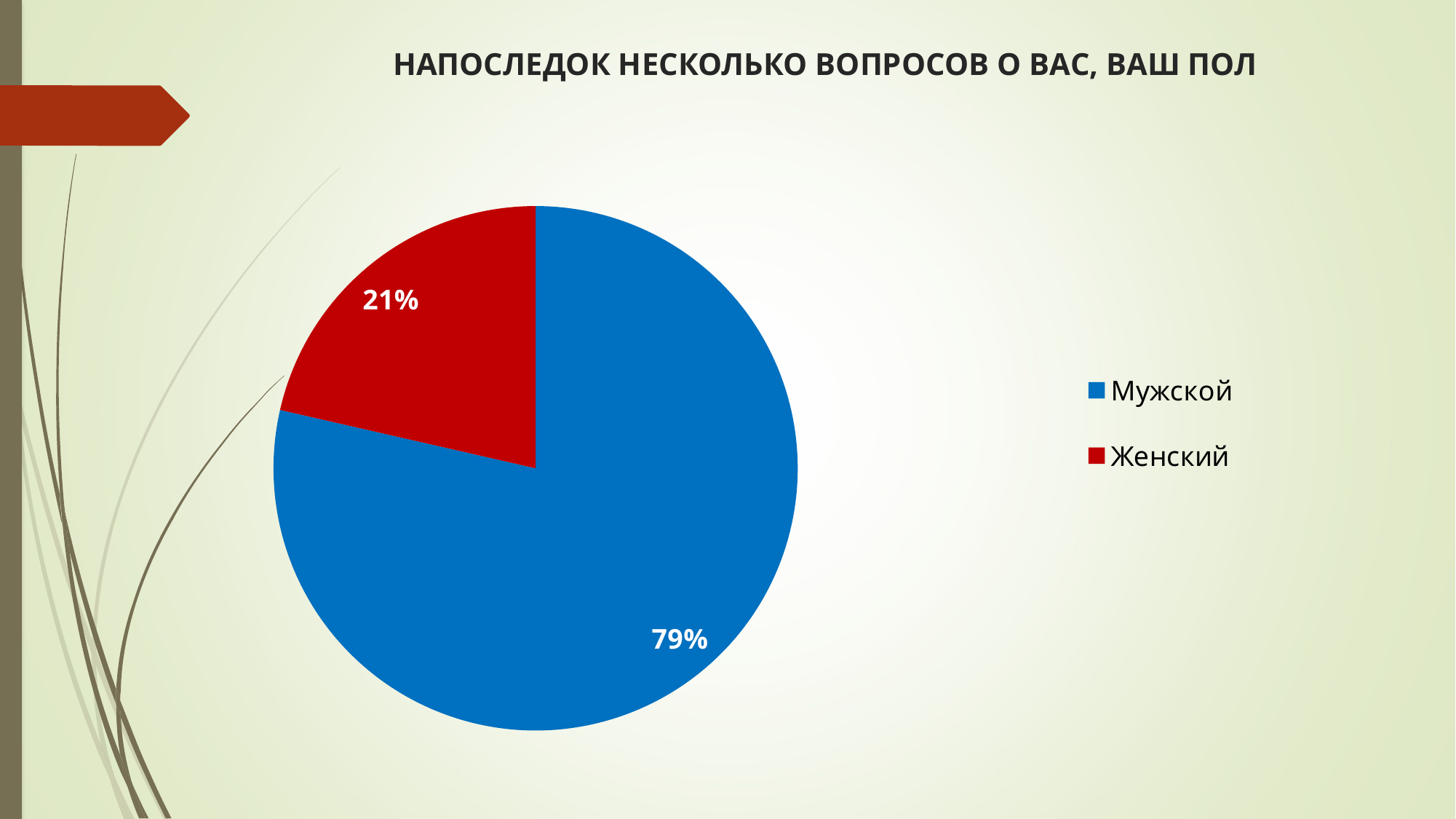
How many entries does the legend list? 2 How many categories are shown in the pie chart? 2 What is the difference in percentage points between Мужской and Женский? 58 Which category has the largest slice of the pie? Мужской What kind of chart is shown on the slide? Pie chart What is the title of the slide? НАПОСЛЕДОК НЕСКОЛЬКО ВОПРОСОВ О ВАС, ВАШ ПОЛ What colour is the slice for Женский? Red What share of the pie does Женский represent? 21% Which is larger, the share for Мужской or the share for Женский? Мужской What share of the pie does Мужской represent? 79% Which category has the smallest slice of the pie? Женский